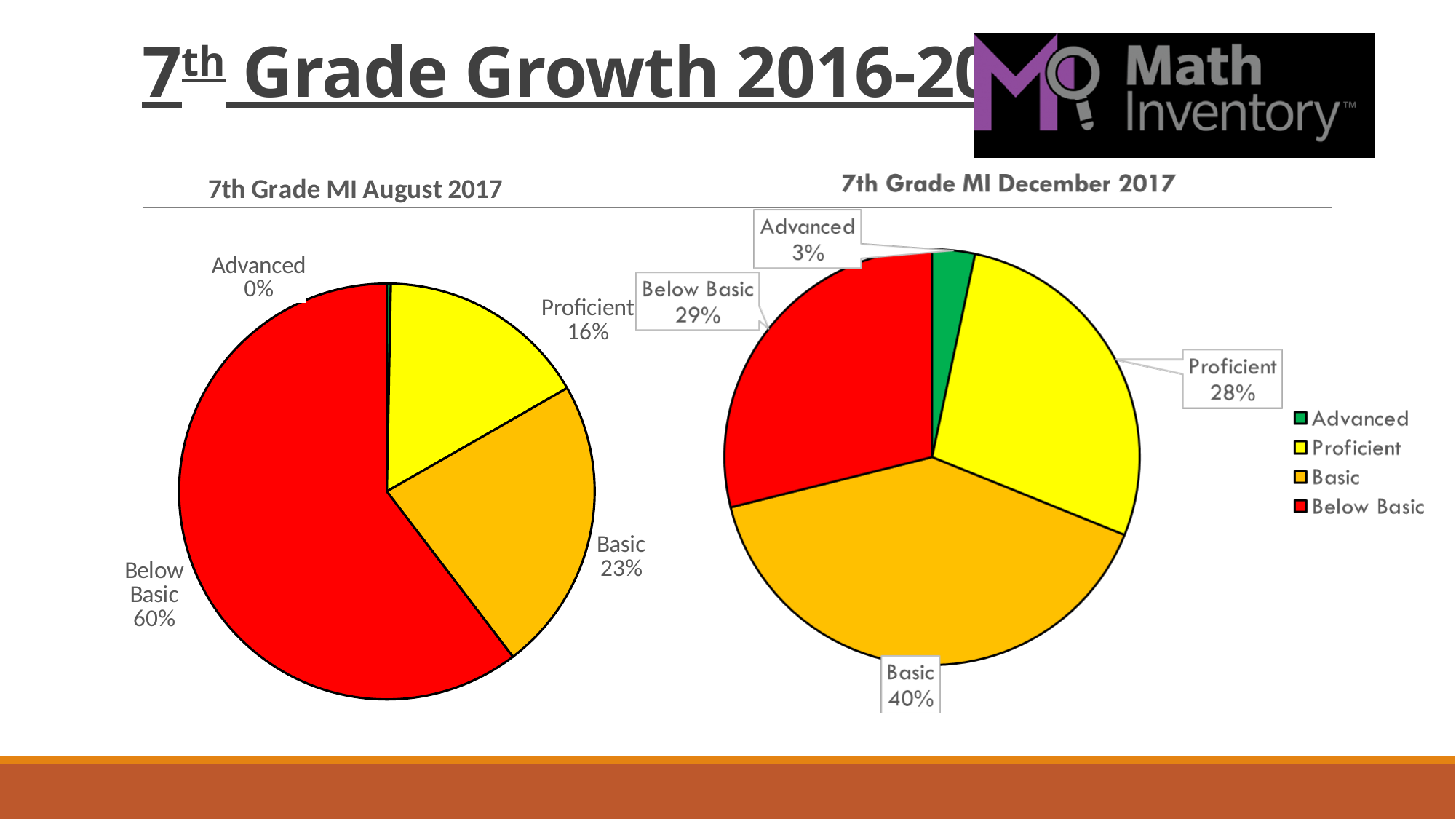
In the '7th Grade MI December 2017' chart, what is the value for Advanced? 3% In the '7th Grade MI August 2017' chart, what share of the pie is Below Basic? 60% How many categories does the '7th Grade MI August 2017' chart show? 4 In the '7th Grade MI December 2017' chart, what share of the pie is Basic? 40% In the '7th Grade MI December 2017' chart, which category has the largest slice? Basic In the '7th Grade MI August 2017' chart, what is the value for Proficient? 16% In the '7th Grade MI December 2017' chart, what is the difference between Basic and Below Basic? 11% What kind of chart is the '7th Grade MI December 2017' chart? Pie chart In the '7th Grade MI August 2017' chart, which category has the smallest slice? Advanced How many entries does the legend of the '7th Grade MI December 2017' chart list? 4 In the '7th Grade MI August 2017' chart, which is larger, Basic or Proficient? Basic In the '7th Grade MI August 2017' chart, what is the value for Advanced? 0%